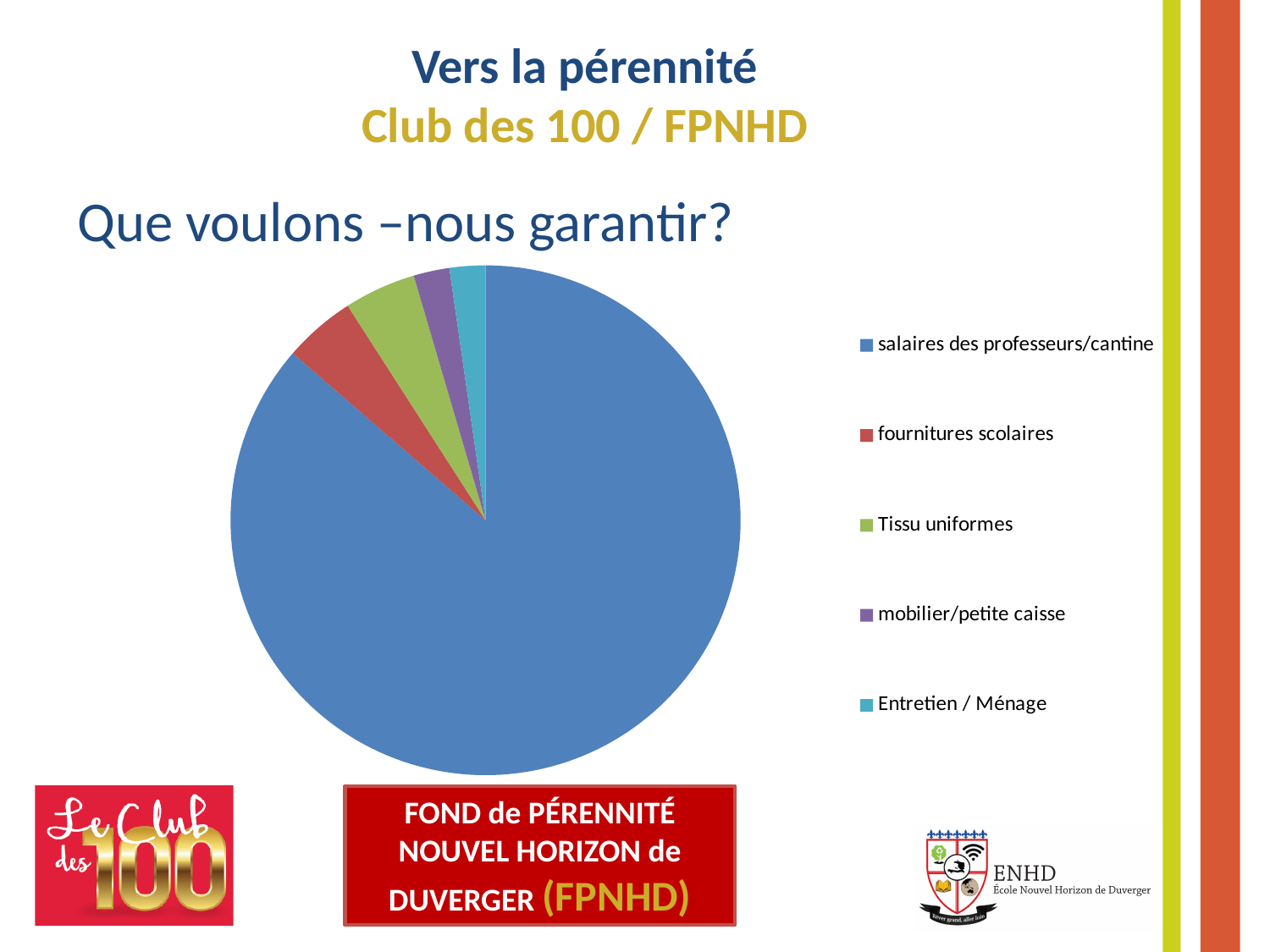
Which category is shown in blue in the pie chart? salaires des professeurs/cantine How many slices does the pie chart have? 5 What kind of chart is shown on the slide? pie chart How many categories does the legend of the pie chart list? 5 Which category takes up the largest share of the pie chart? salaires des professeurs/cantine Which is larger in the pie chart: salaires des professeurs/cantine or fournitures scolaires? salaires des professeurs/cantine Does the slice for salaires des professeurs/cantine take up more or less than half of the pie? more Which is larger in the pie chart: fournitures scolaires or Entretien / Ménage? fournitures scolaires Which colour represents fournitures scolaires in the pie chart? red